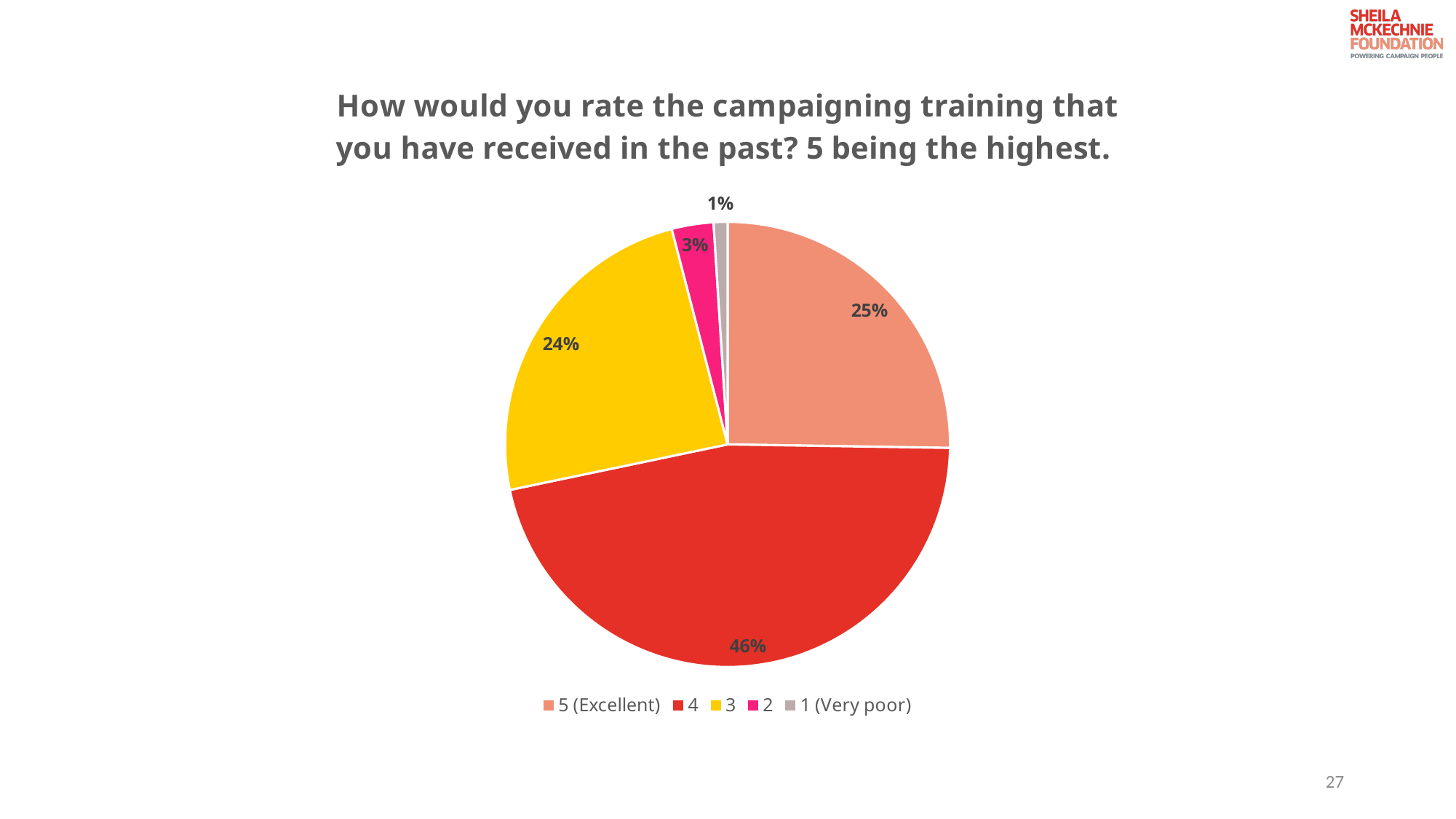
What type of chart is shown on the slide? pie chart What percentage of respondents rated the training 1 (Very poor)? 1% How many categories does the legend list? 5 What is the difference in percentage points between the share rating 4 and the share rating 5 (Excellent)? 21 What percentage of respondents rated the training 5 (Excellent)? 25% Which rating has the smallest share of the pie? 1 (Very poor) Which rating has the largest share of the pie? 4 Which is larger: the share rating 2 or the share rating 1 (Very poor)? 2 What percentage of respondents rated the training 3? 24% What is the combined percentage of respondents who rated the training 4 or 5 (Excellent)? 71% What percentage of respondents rated the campaigning training 4? 46% What colour is the slice for rating 3? yellow